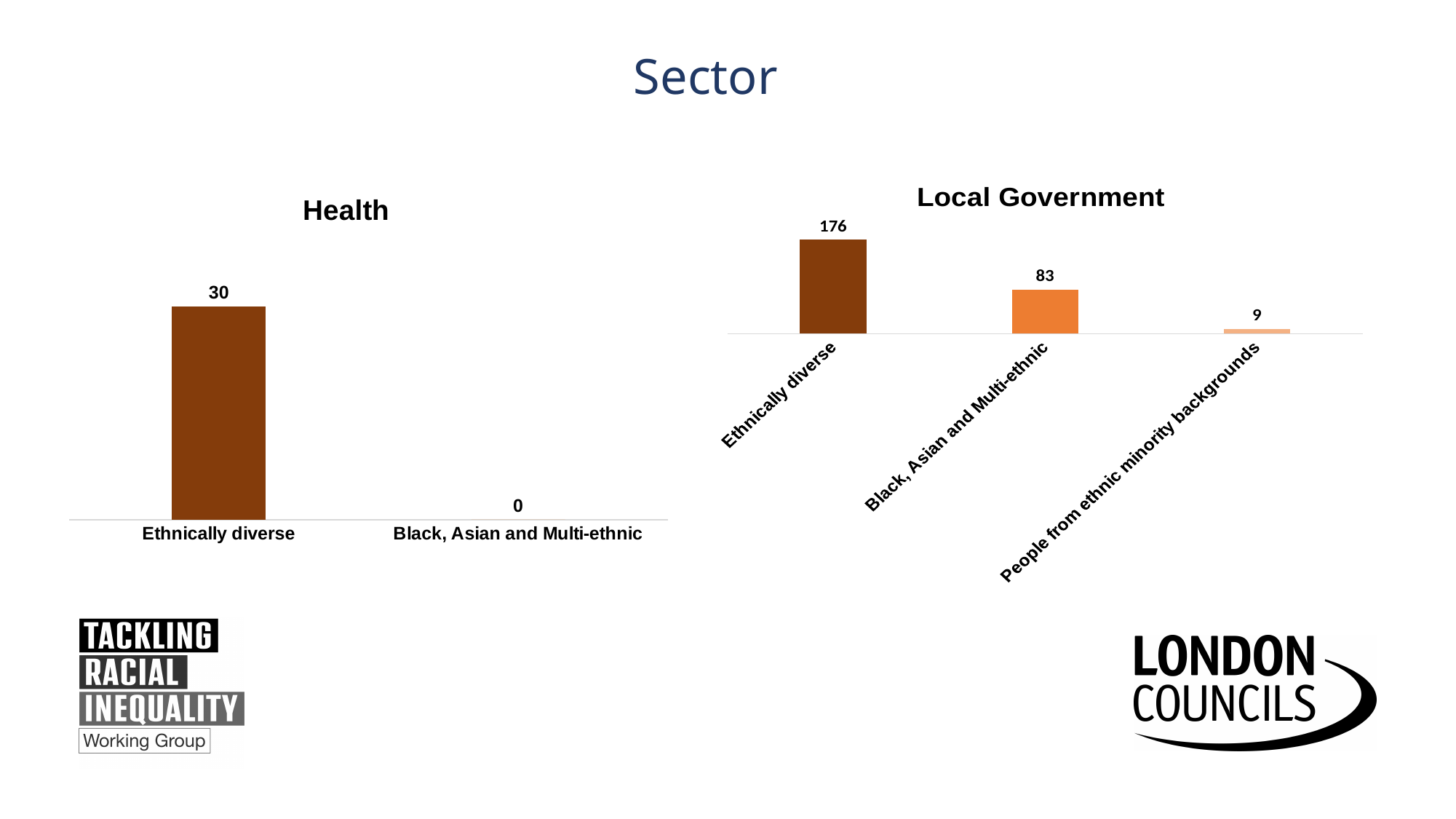
In the Local Government chart, what is the value for Ethnically diverse? 176 What kind of chart is the Health chart? Bar chart In the Local Government chart, what is the value for People from ethnic minority backgrounds? 9 In the Health chart, what is the value for Ethnically diverse? 30 In the Health chart, what is the value for Black, Asian and Multi-ethnic? 0 In the Local Government chart, which category has the lowest value? People from ethnic minority backgrounds In the Local Government chart, which category has the highest value? Ethnically diverse Which is larger: the Ethnically diverse value in the Health chart or the Ethnically diverse value in the Local Government chart? Local Government How many categories are shown in the Local Government chart? 3 In the Local Government chart, what is the difference between the values for Ethnically diverse and Black, Asian and Multi-ethnic? 93 In the Local Government chart, what is the value for Black, Asian and Multi-ethnic? 83 In the Health chart, what is the difference between the values for Ethnically diverse and Black, Asian and Multi-ethnic? 30